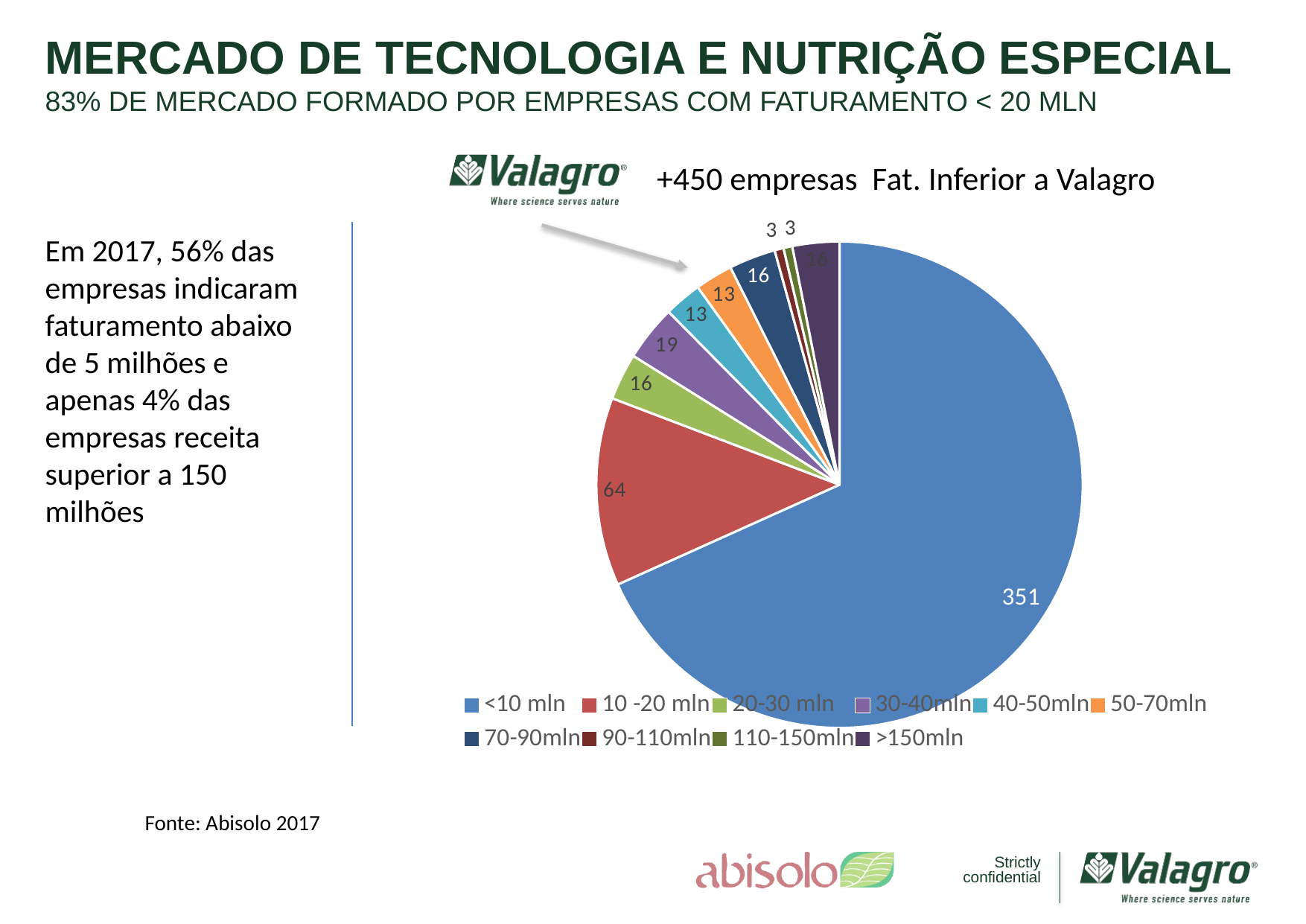
What source is cited for the chart? Abisolo 2017 What value is shown for the 30-40mln slice? 19 What is the difference between the 30-40mln slice and the 40-50mln slice? 6 What colour is the largest slice of the pie chart? Blue Which category has the largest slice of the pie? <10 mln How many slices does the pie chart have? 10 Which is larger, the 10 -20 mln slice or the 20-30 mln slice? 10 -20 mln What kind of chart is shown on the slide? Pie chart What value is shown for the 10 -20 mln slice? 64 What value is shown for the <10 mln slice? 351 What value is shown for the >150mln slice? 16 What is the difference between the <10 mln slice and the 10 -20 mln slice? 287